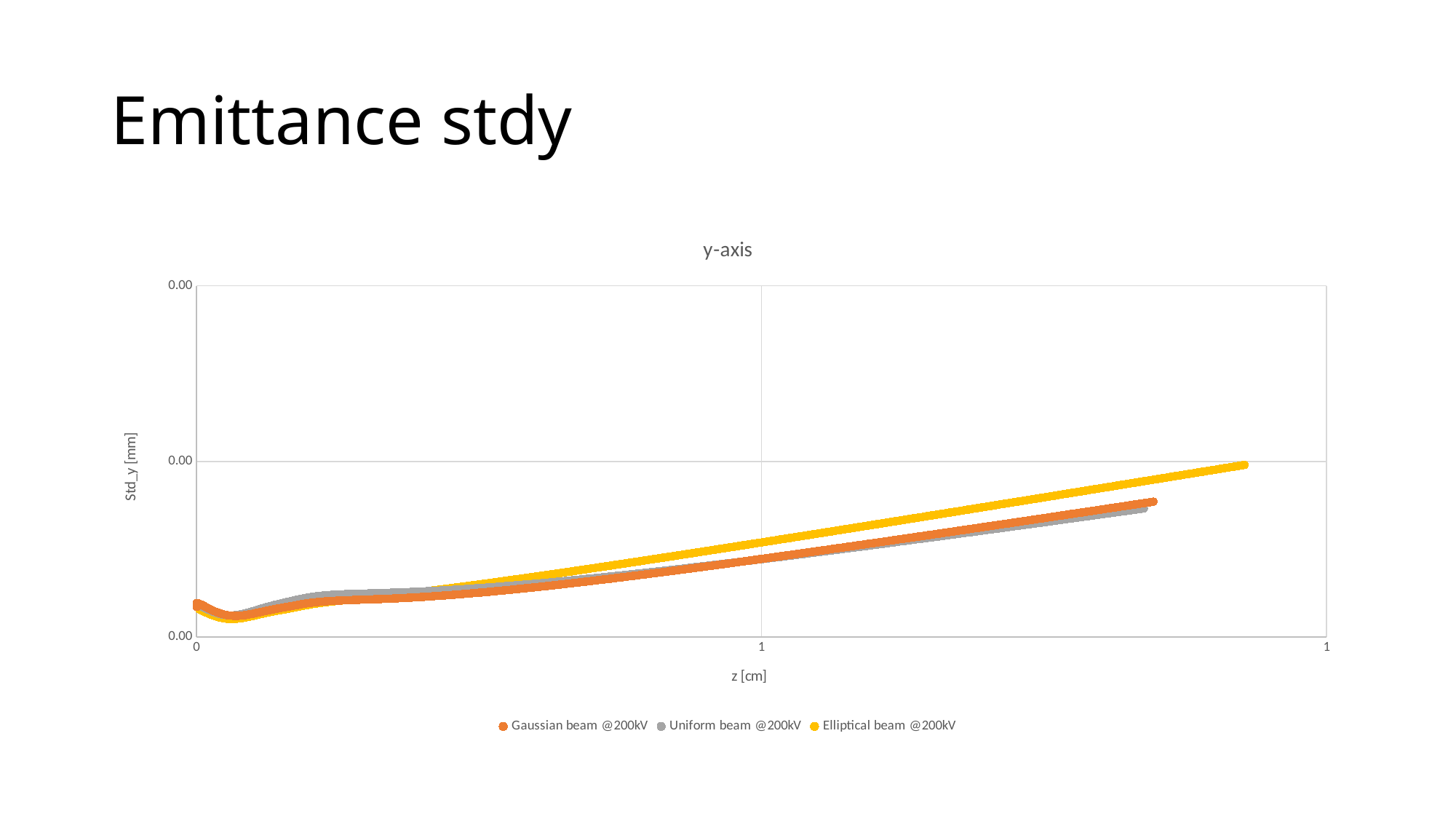
What is the label on the horizontal axis of the chart? z [cm] How many series does the legend list? 3 At the right end of the plotted data, is the Elliptical beam @200kV series above or below the Gaussian beam @200kV series? above Which series extends furthest along the z axis? Elliptical beam @200kV What is the title of the chart? y-axis What kind of chart is shown on the slide? scatter chart Which series reaches the highest Std_y value at the right end of the chart? Elliptical beam @200kV Do the Std_y values overall rise or fall as z increases? rise